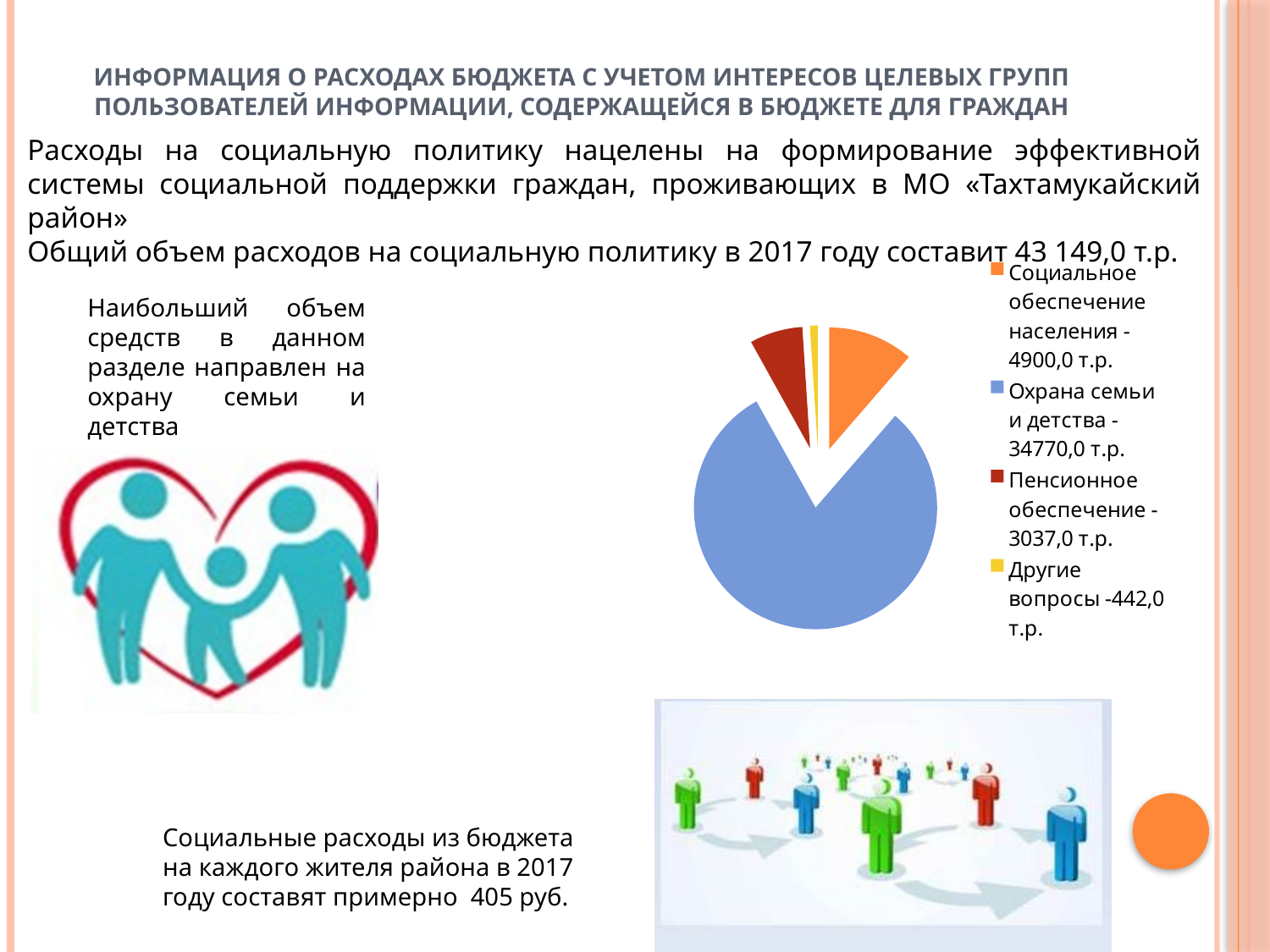
Which category has the smallest slice of the pie chart? Другие вопросы What is the value for Социальное обеспечение населения in the pie chart? 4900,0 т.р. What is the value for Охрана семьи и детства in the pie chart? 34770,0 т.р. What is the difference between Пенсионное обеспечение and Другие вопросы? 2595,0 т.р. Which is larger: Социальное обеспечение населения or Пенсионное обеспечение? Социальное обеспечение населения What is the difference between Охрана семьи и детства and Социальное обеспечение населения? 29870,0 т.р. What kind of chart is shown on the slide? Pie chart What is the value for Пенсионное обеспечение in the pie chart? 3037,0 т.р. How many categories does the pie chart show? 4 What is the value for Другие вопросы in the pie chart? 442,0 т.р. What colour is the slice for Охрана семьи и детства in the pie chart? Blue Which category has the largest slice of the pie chart? Охрана семьи и детства